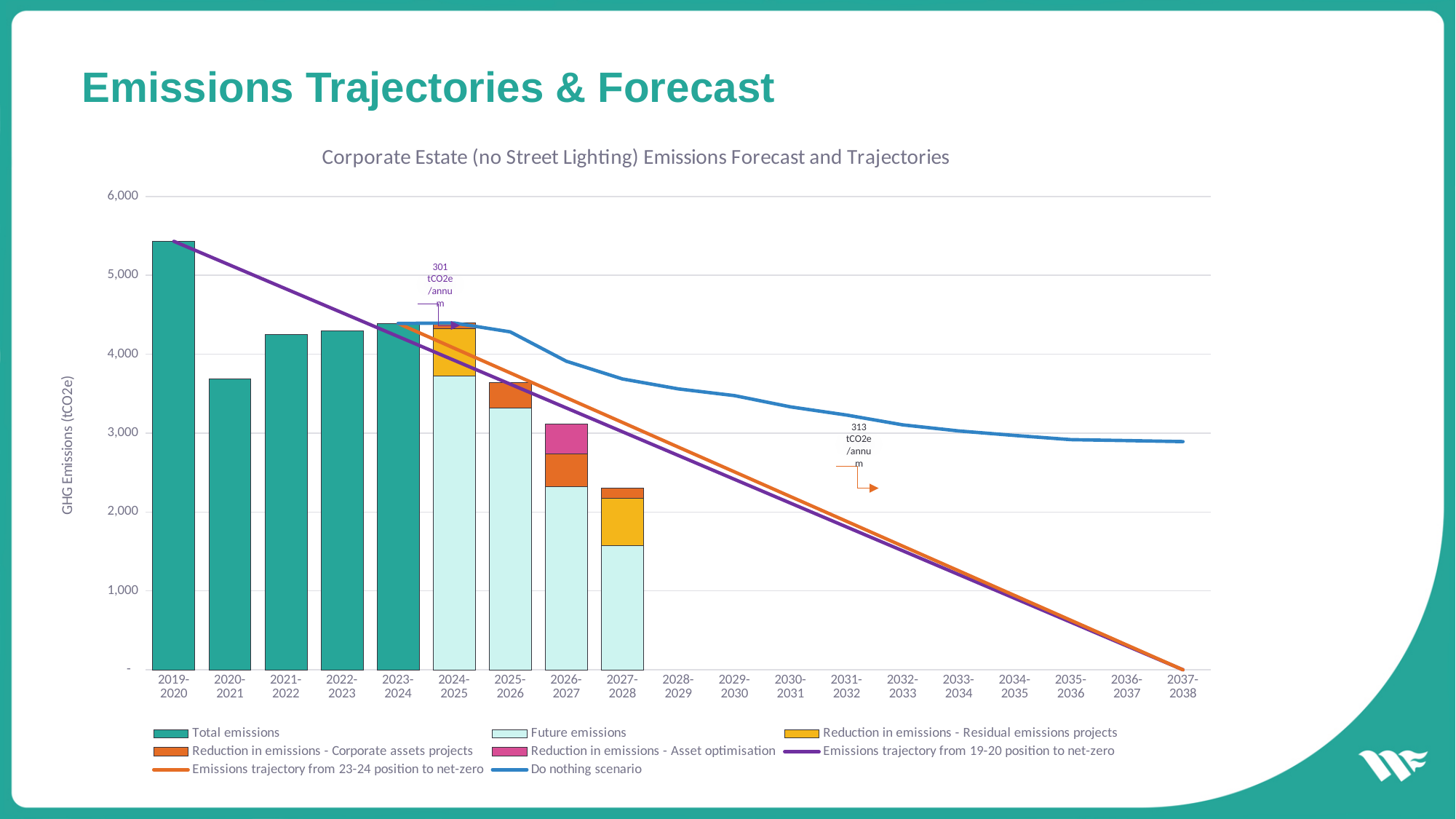
Is the Do nothing scenario value for 2037-2038 greater or less than 3,000? less Which year has the highest Total emissions bar? 2019-2020 How many series does the chart legend list? 8 How many year categories are shown on the x axis? 19 What kind of chart is shown on the slide? Combined bar and line chart Is the Total emissions value for 2019-2020 greater or less than 5,000? greater Is the Total emissions value for 2021-2022 greater or less than 4,000? greater Which is larger, the Total emissions bar for 2019-2020 or for 2023-2024? 2019-2020 What is the title of the chart? Corporate Estate (no Street Lighting) Emissions Forecast and Trajectories Which year has the lowest Total emissions bar among the teal bars? 2020-2021 What is the annual reduction rate annotated on the Emissions trajectory from 23-24 position to net-zero line? 313 tCO2e/annum